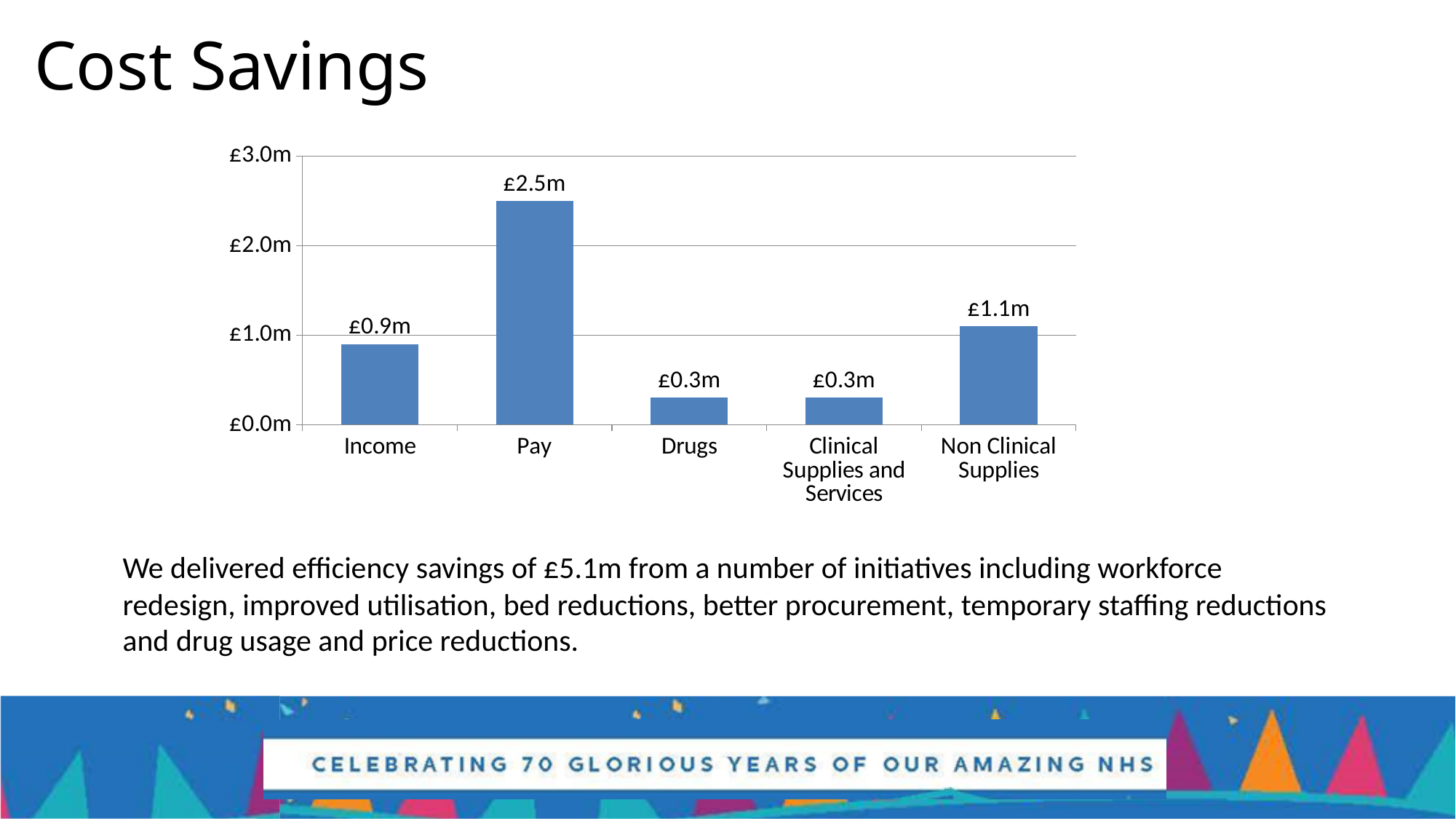
Is the value for Pay greater or less than £2.0m? greater What is the cost saving value for Drugs? £0.3m Which category has the highest cost saving? Pay What is the difference between the cost savings for Non Clinical Supplies and Drugs? £0.8m What is the cost saving value for Pay? £2.5m What is the cost saving value for Income? £0.9m What is the difference between the cost savings for Pay and Income? £1.6m What is the cost saving value for Non Clinical Supplies? £1.1m Which is larger, the cost saving for Income or for Non Clinical Supplies? Non Clinical Supplies How many categories are shown on the chart? 5 What is the title of the slide containing the chart? Cost Savings What kind of chart is shown on the slide? Bar chart